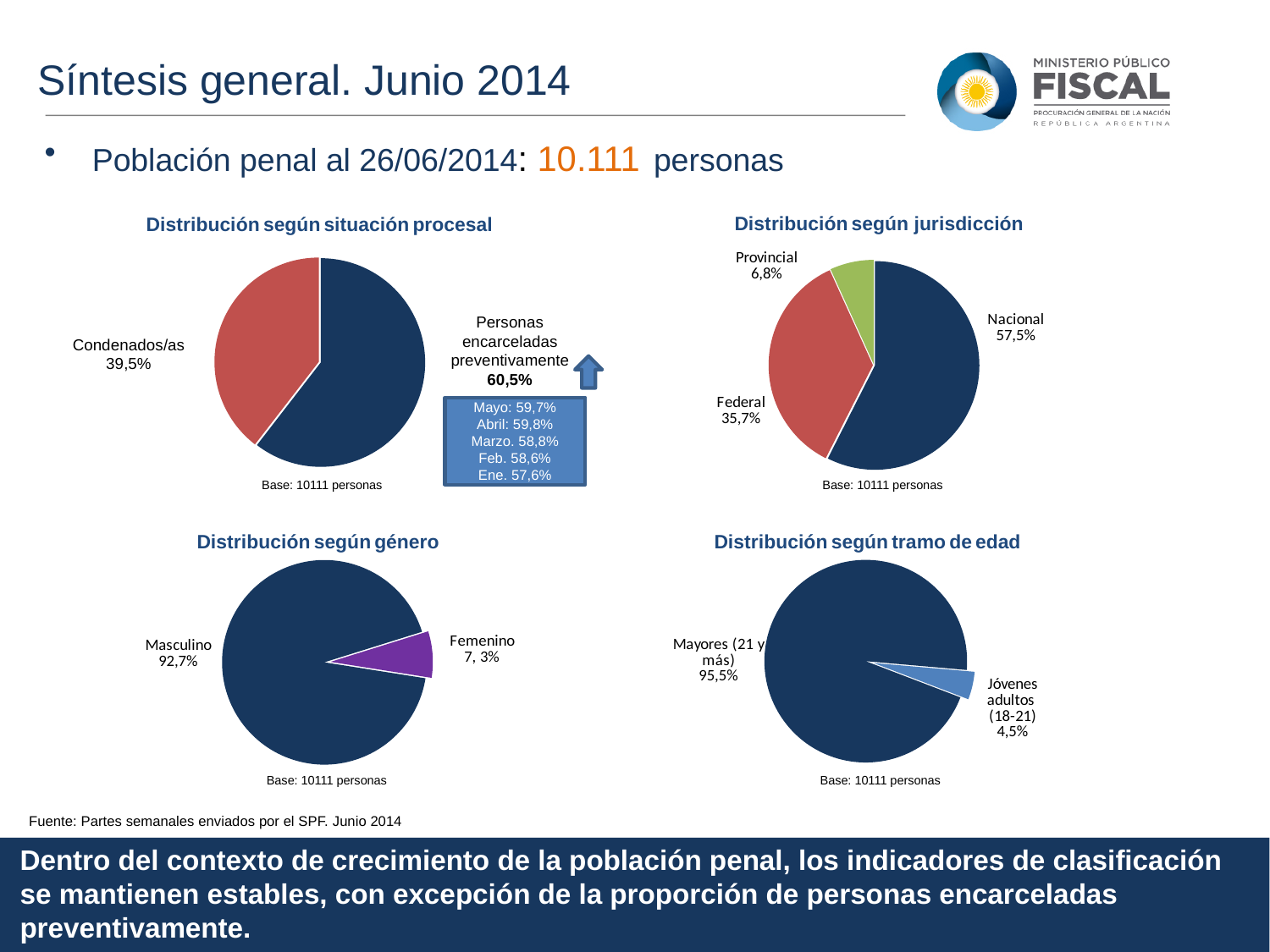
In the 'Distribución según situación procesal' chart, what percentage is shown for Personas encarceladas preventivamente? 60,5% In the 'Distribución según jurisdicción' chart, which category has the smallest share? Provincial What type of chart is 'Distribución según género'? Pie chart In the 'Distribución según jurisdicción' chart, what percentage is shown for Federal? 35,7% In the 'Distribución según jurisdicción' chart, what is the difference in percentage points between Nacional and Federal? 21,8 How many categories are shown in the 'Distribución según jurisdicción' chart? 3 In the 'Distribución según género' chart, what percentage is shown for Masculino? 92,7% In the 'Distribución según tramo de edad' chart, what percentage is shown for Jóvenes adultos (18-21)? 4,5% In the 'Distribución según situación procesal' chart, what percentage is shown for Condenados/as? 39,5% What base (number of persons) is stated below the 'Distribución según situación procesal' chart? 10111 personas In the 'Distribución según tramo de edad' chart, which is larger: Mayores (21 y más) or Jóvenes adultos (18-21)? Mayores (21 y más) In the 'Distribución según jurisdicción' chart, which category has the largest share? Nacional